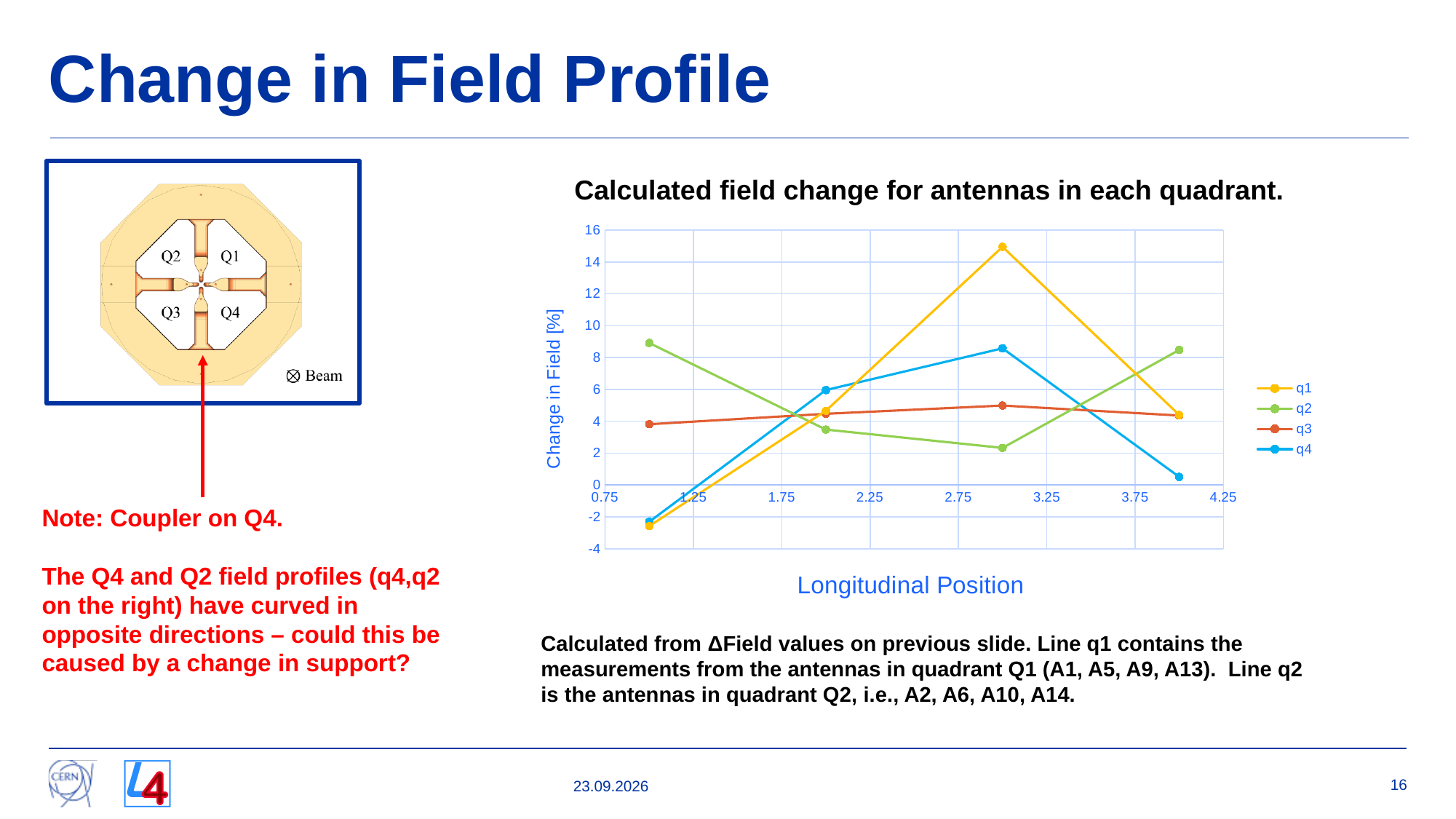
At longitudinal position 3, which is larger, q1 or q3? q1 What kind of chart is shown on the slide? line chart What is the label of the vertical axis of the chart? Change in Field [%] Is the first point of q2 (at longitudinal position 1) greater or less than 8? greater At longitudinal position 1, which is larger, q2 or q4? q2 Is the value of q4 at longitudinal position 3 greater or less than 6? greater Does the q1 series rise or fall between longitudinal positions 3 and 4? fall Which series reaches the highest value on the chart? q1 How many series does the legend list? 4 How many data points does the q1 series have? 4 Is the peak value of q1 greater or less than 14? greater Which series has the lowest value at longitudinal position 3? q2